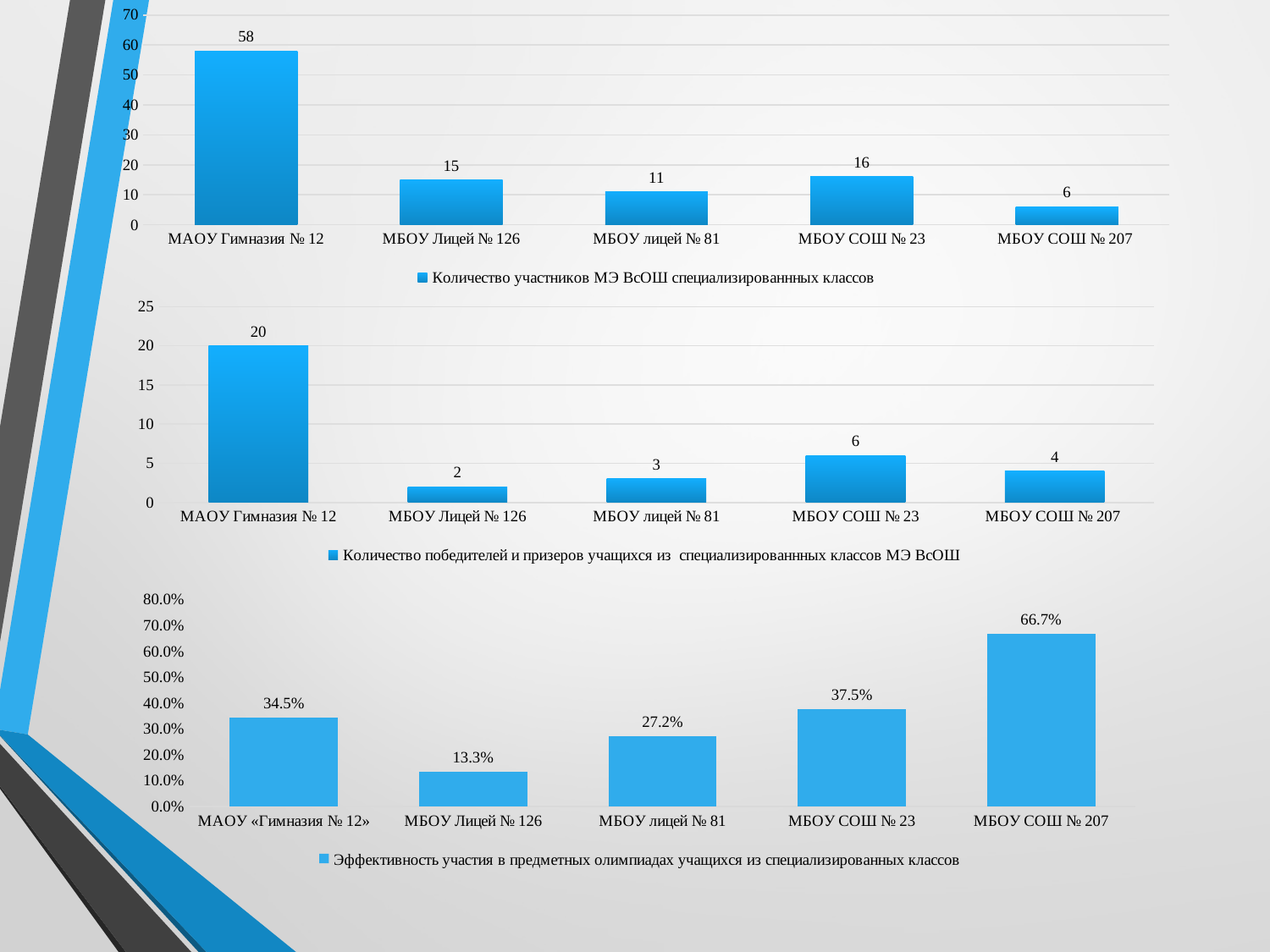
In the bottom chart (Эффективность участия), which school has the lowest value? МБОУ Лицей № 126 In the top chart (Количество участников МЭ ВсОШ специализированных классов), how many schools are shown? 5 In the bottom chart (Эффективность участия), what is the difference between МБОУ СОШ № 23 and МБОУ лицей № 81? 10.3% In the middle chart (Количество победителей и призеров), which is larger: МБОУ Лицей № 126 or МБОУ лицей № 81? МБОУ лицей № 81 In the middle chart (Количество победителей и призеров), which school has the highest value? МАОУ Гимназия № 12 How many series does the legend of the middle chart list? 1 In the middle chart (Количество победителей и призеров), what is the value for МБОУ СОШ № 23? 6 In the top chart (Количество участников МЭ ВсОШ специализированных классов), what is the difference between МБОУ СОШ № 23 and МБОУ лицей № 81? 5 In the bottom chart (Эффективность участия), what is the value for МБОУ СОШ № 207? 66.7% In the top chart (Количество участников МЭ ВсОШ специализированных классов), which school has the lowest value? МБОУ СОШ № 207 In the top chart (Количество участников МЭ ВсОШ специализированных классов), what is the value for МАОУ Гимназия № 12? 58 What type of chart is the bottom chart (Эффективность участия)? bar chart